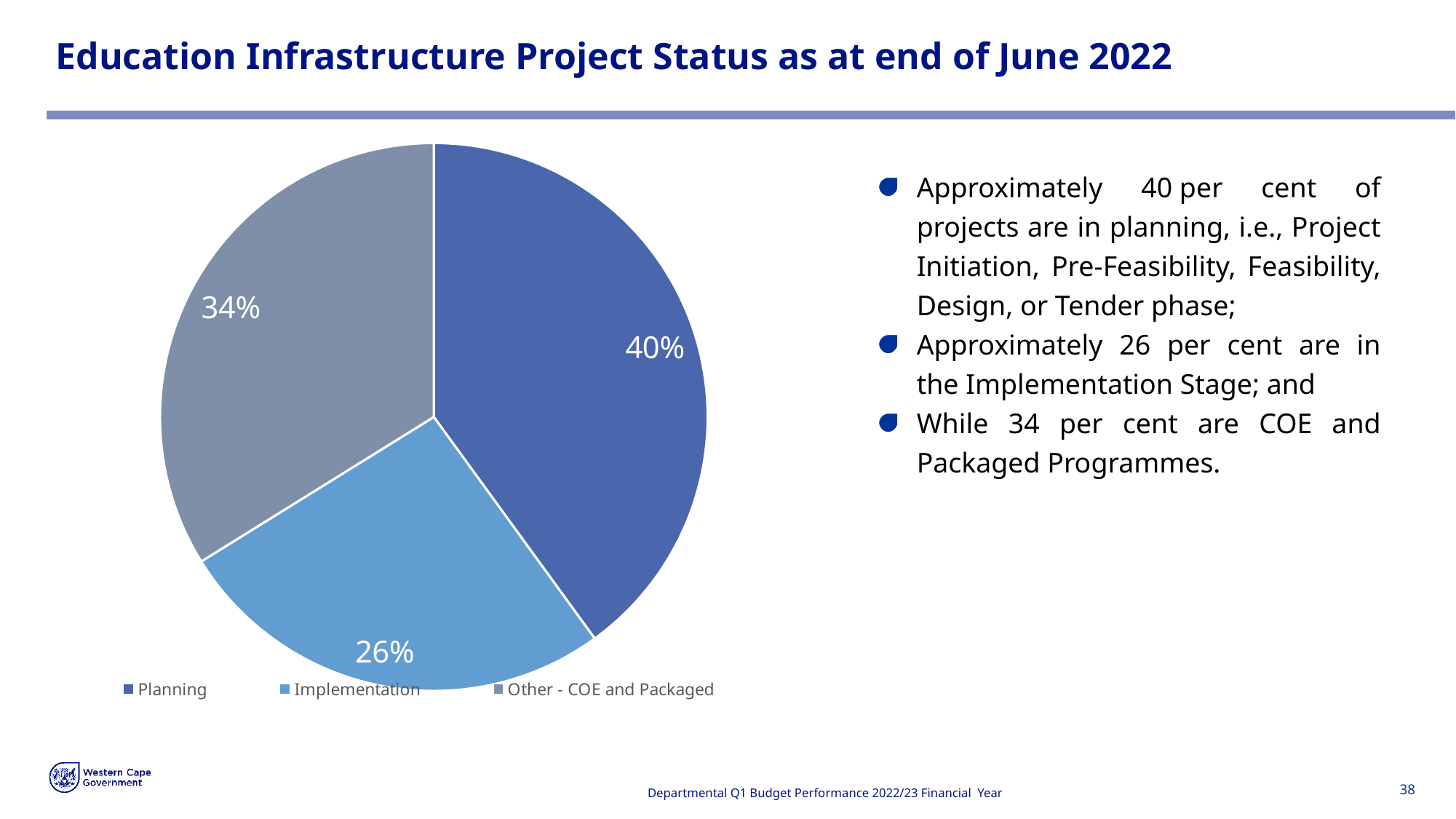
What share of projects is in the Implementation category? 26% How many categories does the pie chart show? 3 Which is larger, the Planning share or the Other - COE and Packaged share? Planning Which legend entry is shown in the lightest blue colour? Implementation What share of projects is in the Planning category? 40% What is the title of the slide containing the chart? Education Infrastructure Project Status as at end of June 2022 What kind of chart is shown on the slide? Pie chart What is the difference in percentage points between the Other - COE and Packaged share and the Implementation share? 8 Which category has the smallest share of the pie? Implementation What is the difference in percentage points between the Planning and Implementation shares? 14 Which category has the largest share of the pie? Planning What share of projects is in the Other - COE and Packaged category? 34%